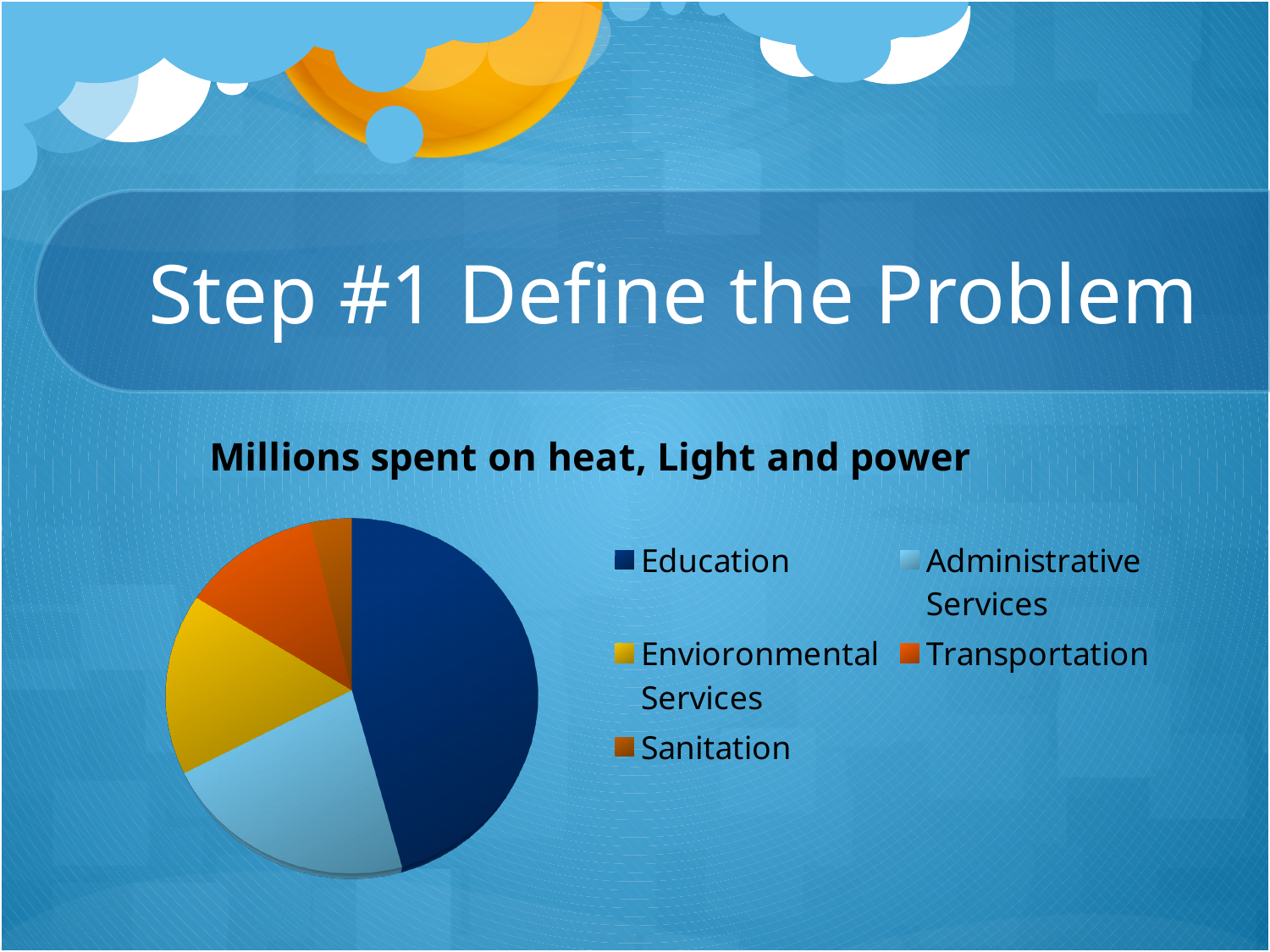
What kind of chart is shown on the slide? pie chart Which category has the largest slice of the pie? Education What is the title of the chart? Millions spent on heat, Light and power What colour is the Education slice in the pie chart? dark blue Which slice is larger, Administrative Services or Sanitation? Administrative Services Which slice is larger, Envioronmental Services or Sanitation? Envioronmental Services Which category has the smallest slice of the pie? Sanitation Which slice is larger, Education or Transportation? Education How many categories does the pie chart have? 5